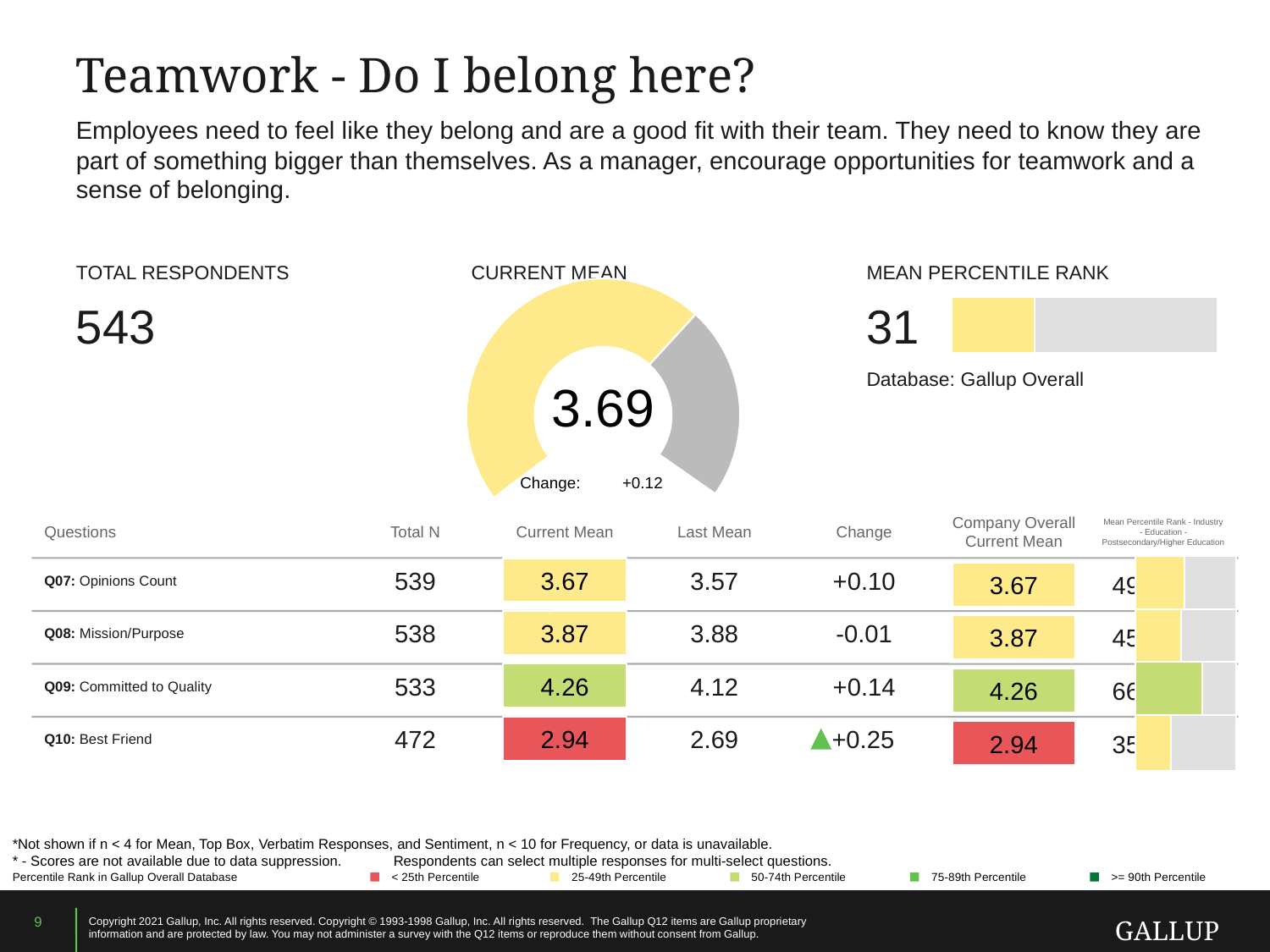
On the Mean Percentile Rank bar chart, is the filled portion of the bar greater or less than half of the bar? less On the Mean Percentile Rank bar chart, what value is shown? 31 Which database is the Mean Percentile Rank chart based on? Gallup Overall In the table's Mean Percentile Rank bar charts, what is the difference between the percentile rank for Q09: Committed to Quality and Q10: Best Friend? 31 In the table's Mean Percentile Rank bar charts, what is the percentile rank for Q07: Opinions Count? 49 On the Current Mean gauge chart, what Change value is shown beneath the gauge? +0.12 In the table's Mean Percentile Rank bar charts, which question has the lowest percentile rank? Q10: Best Friend On the Current Mean gauge chart, what value is shown in the centre? 3.69 What kind of chart is used to display the Current Mean? gauge chart In the table's Mean Percentile Rank bar charts, which question has the highest percentile rank? Q09: Committed to Quality How many questions have Mean Percentile Rank bars shown in the table? 4 In the table's Mean Percentile Rank bar charts, what is the percentile rank for Q09: Committed to Quality? 66